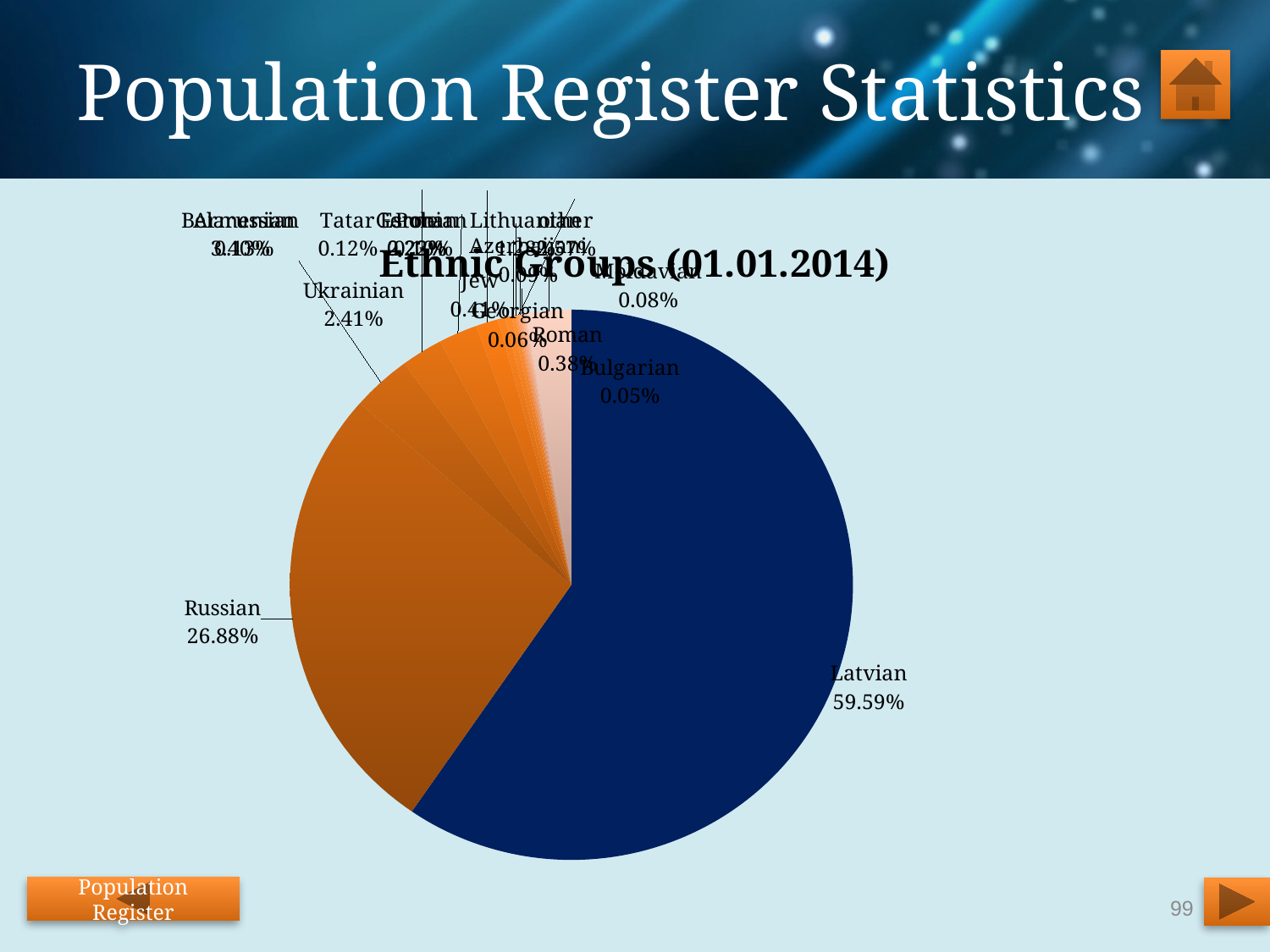
Which is larger, the Moldavian share or the Bulgarian share? Moldavian What share of the pie is Russian? 26.88% What share of the pie is Tatar? 0.12% Which is larger, the Russian share or the Ukrainian share? Russian What share of the pie is Bulgarian? 0.05% Which ethnic group has the largest slice of the pie? Latvian What share of the pie is Moldavian? 0.08% What is the title of the chart? Ethnic Groups (01.01.2014) What share of the pie is Ukrainian? 2.41% What is the difference between the Latvian and Russian shares? 32.71% What share of the pie is Latvian? 59.59% What kind of chart is shown on the slide? pie chart